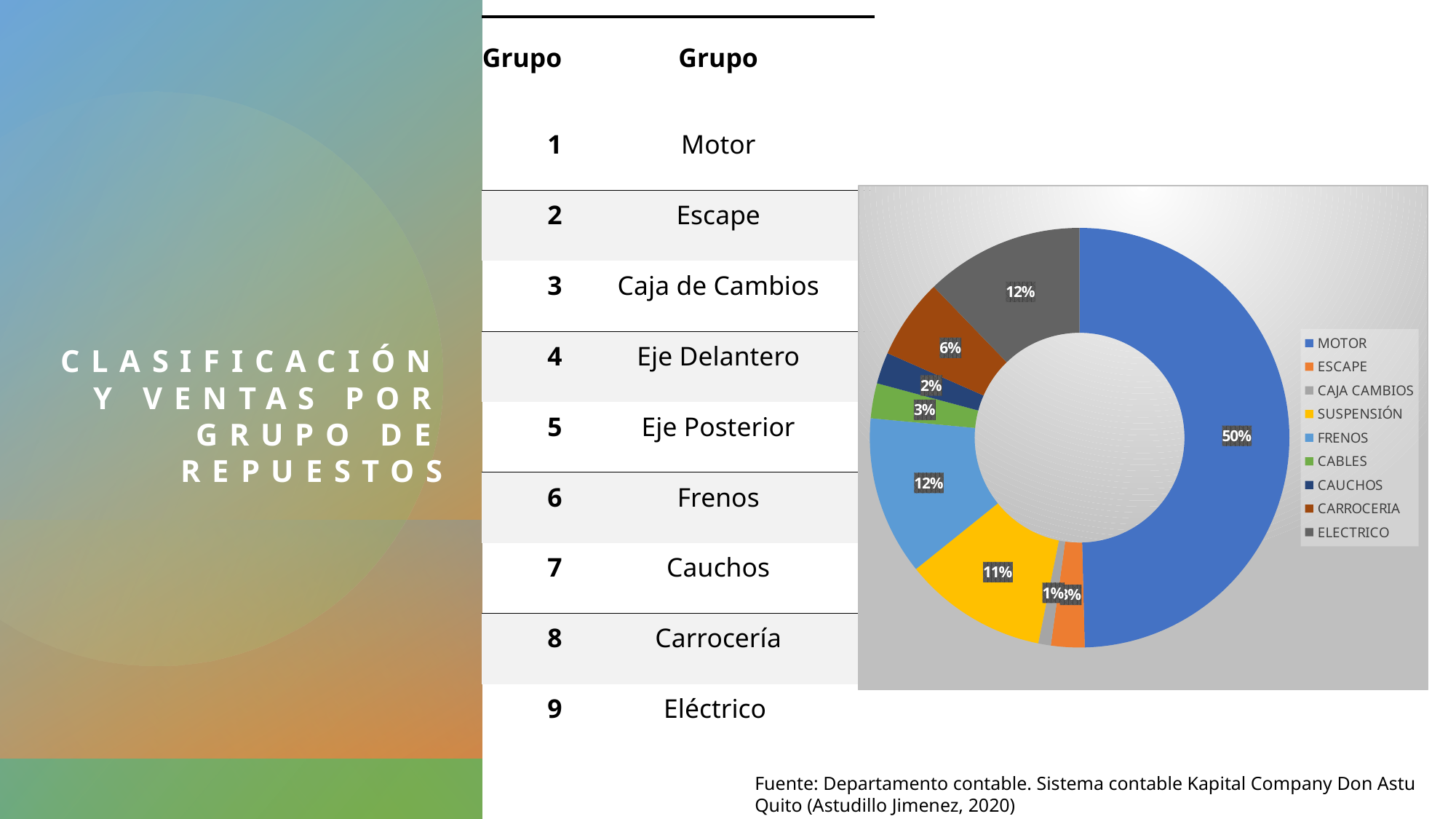
What percentage does the ELECTRICO slice show? 12% What colour is the MOTOR slice? blue What percentage does the SUSPENSIÓN slice show? 11% What percentage does the CAUCHOS slice show? 2% What percentage does the CARROCERIA slice show? 6% Which category has the largest share of the chart? MOTOR What percentage does the MOTOR slice show? 50% Which is larger, the CARROCERIA slice or the CABLES slice? CARROCERIA How many categories does the legend list? 9 What kind of chart is shown on the slide? doughnut chart What percentage does the FRENOS slice show? 12% What percentage does the CABLES slice show? 3%